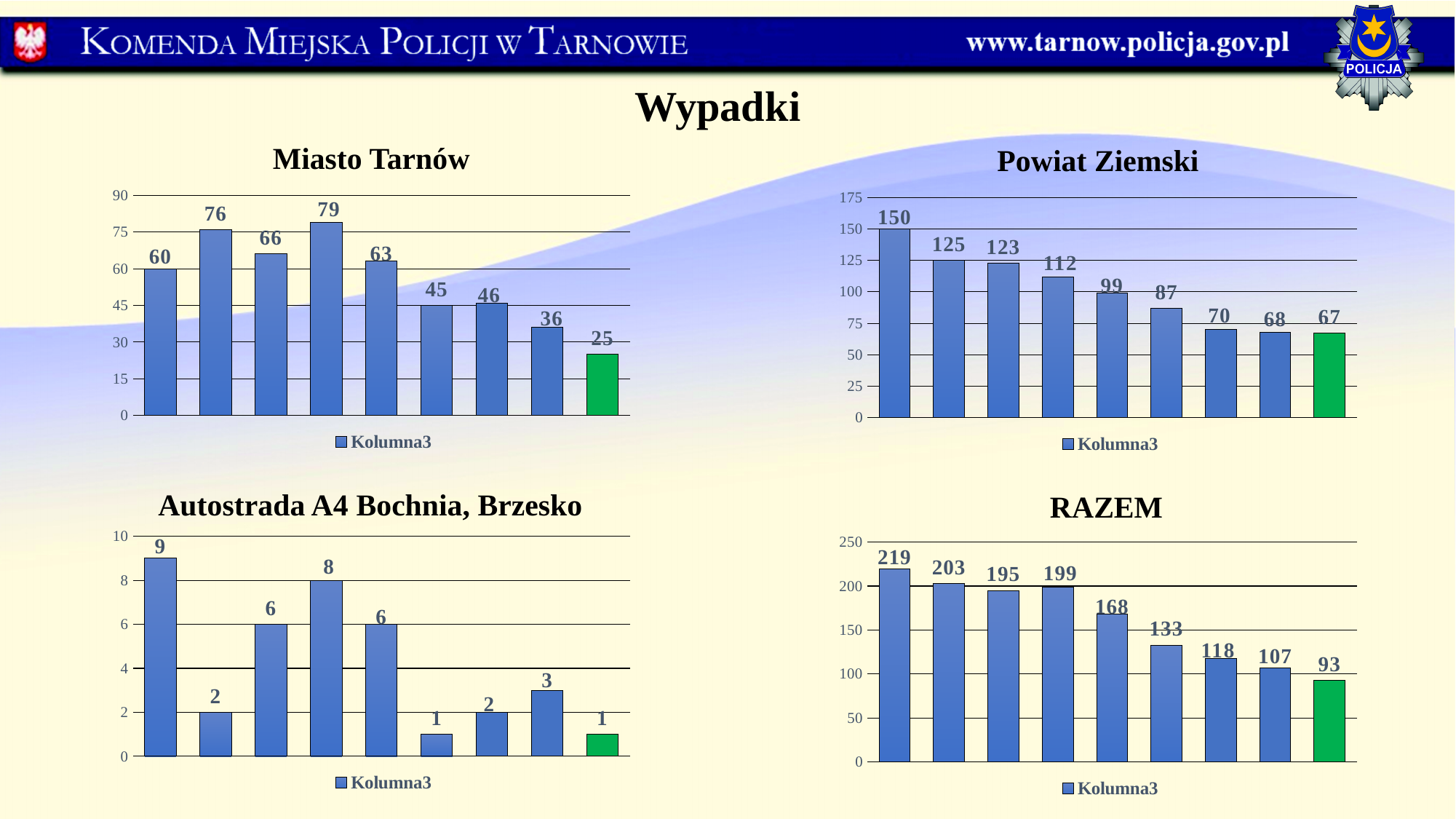
In the RAZEM chart, do the values generally rise or fall from left to right? fall What type of chart is the Miasto Tarnów chart? bar chart In the RAZEM chart, what is the value of the fifth bar? 168 In the Miasto Tarnów chart, what is the highest value shown? 79 In the Miasto Tarnów chart, what is the value of the last (green) bar? 25 In the Powiat Ziemski chart, what is the lowest value shown? 67 In the Powiat Ziemski chart, what is the value of the first bar? 150 In the Miasto Tarnów chart, what is the difference between the first bar and the last bar? 35 In the Autostrada A4 Bochnia, Brzesko chart, what is the highest value shown? 9 In the Powiat Ziemski chart, what is the difference between the first bar and the last bar? 83 In the Autostrada A4 Bochnia, Brzesko chart, how many bars are plotted? 9 In the RAZEM chart, which is larger, the third bar or the fourth bar? the fourth bar